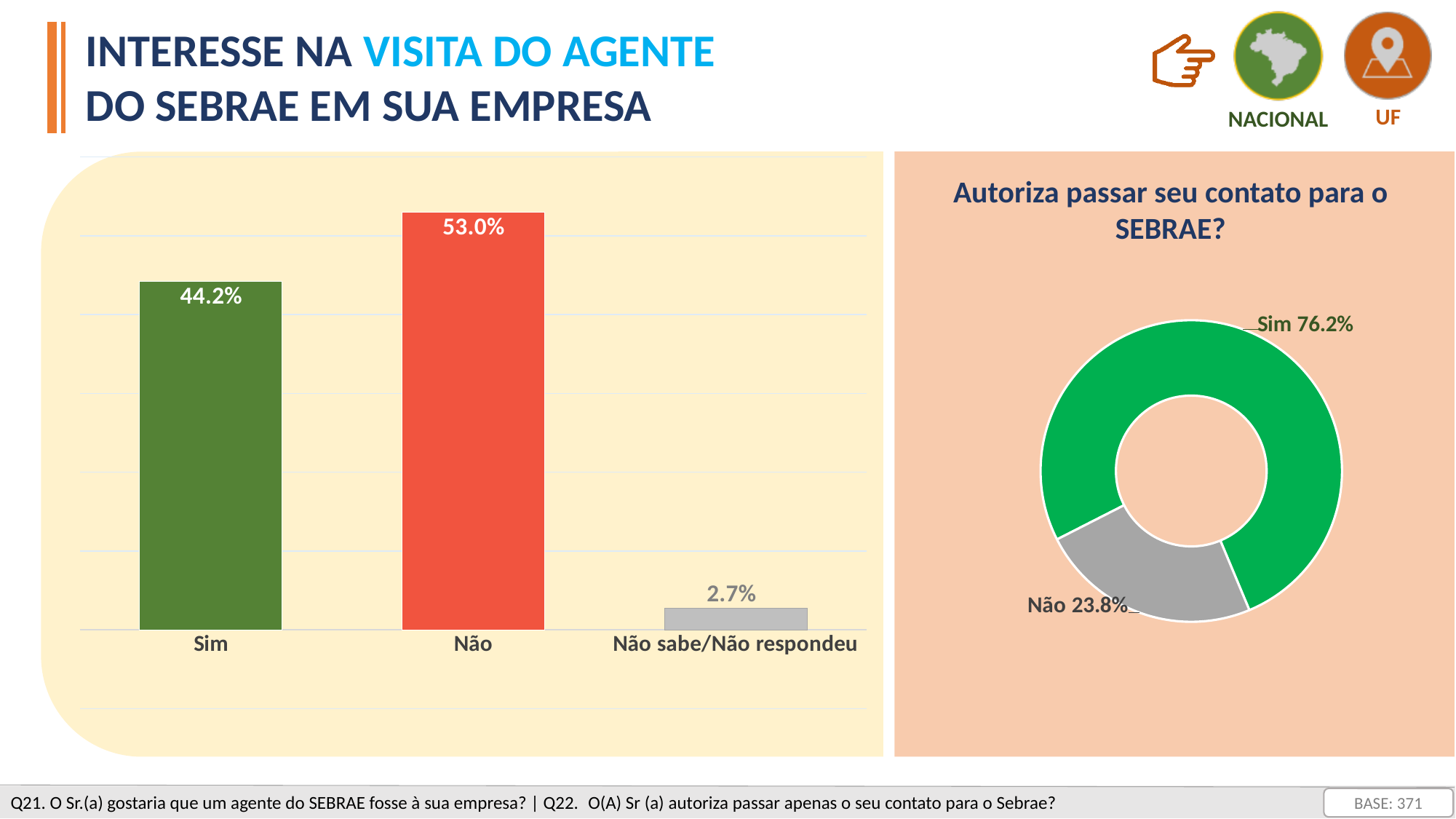
How many categories are shown in the bar chart on the left? 3 In the chart titled "Autoriza passar seu contato para o SEBRAE?", what is the value for "Sim"? 76.2% What kind of chart is the chart on the left? Bar chart In the bar chart on the left, what is the value for "Não"? 53.0% In the bar chart on the left, which is larger: the value for "Sim" or the value for "Não"? Não In the chart titled "Autoriza passar seu contato para o SEBRAE?", what is the value for "Não"? 23.8% In the bar chart on the left, what is the value for "Sim"? 44.2% In the bar chart on the left, what is the value for "Não sabe/Não respondeu"? 2.7% What kind of chart is the chart titled "Autoriza passar seu contato para o SEBRAE?"? Doughnut chart In the bar chart on the left, what is the difference between the values for "Não" and "Sim"? 8.8% In the bar chart on the left, which category has the highest value? Não In the bar chart on the left, which category has the lowest value? Não sabe/Não respondeu